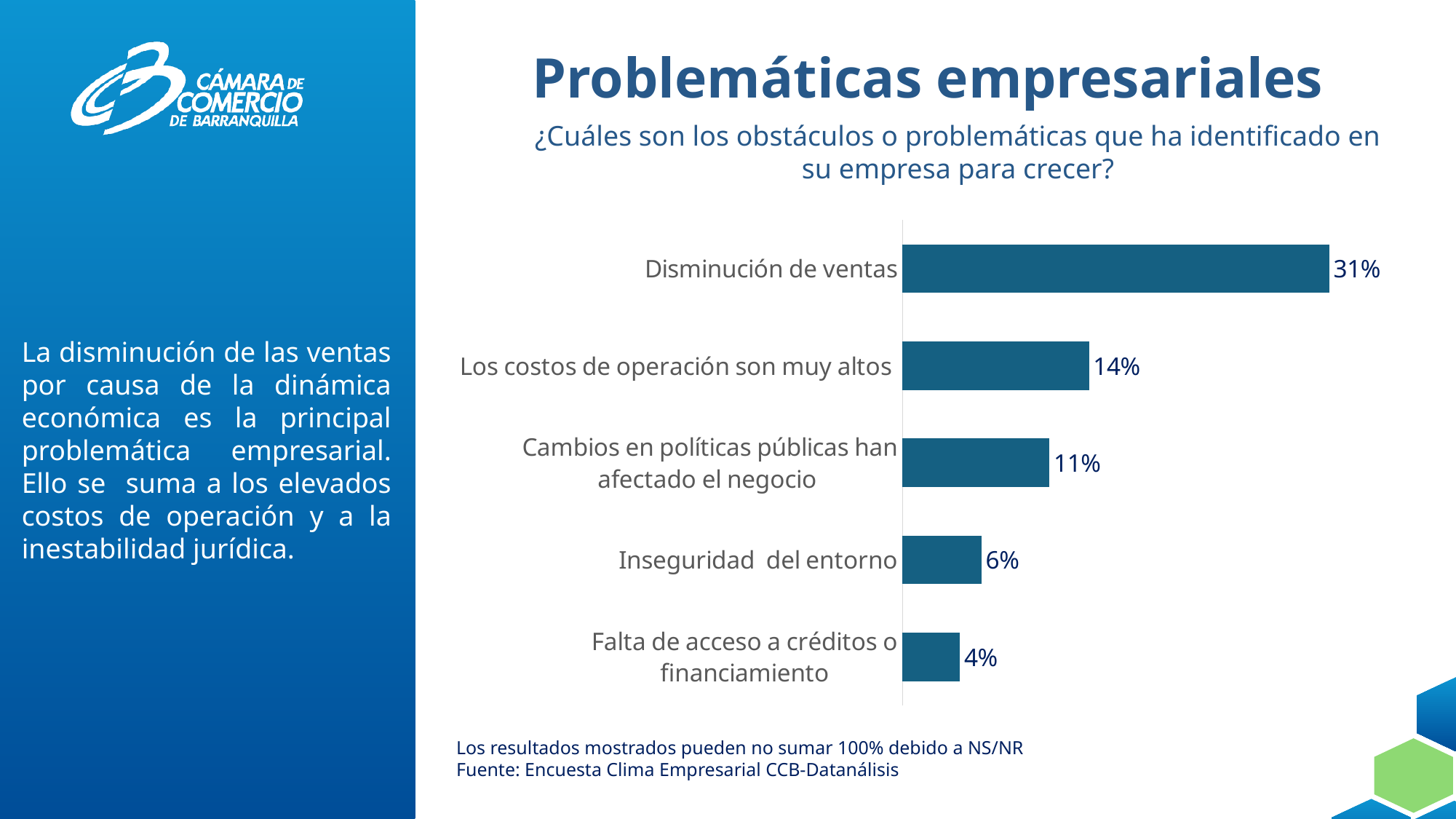
What is the value for "Falta de acceso a créditos o financiamiento"? 4% Which category has the lowest value? Falta de acceso a créditos o financiamiento What is the value for "Inseguridad del entorno"? 6% How many categories are shown in the chart? 5 Which is larger, the value for "Inseguridad del entorno" or the value for "Falta de acceso a créditos o financiamiento"? Inseguridad del entorno Which category has the highest value? Disminución de ventas What is the difference between the values for "Disminución de ventas" and "Los costos de operación son muy altos"? 17% What is the value for "Disminución de ventas"? 31% What is the title of the slide containing the chart? Problemáticas empresariales What is the value for "Los costos de operación son muy altos"? 14% What kind of chart is shown on the slide? Bar chart What is the value for "Cambios en políticas públicas han afectado el negocio"? 11%